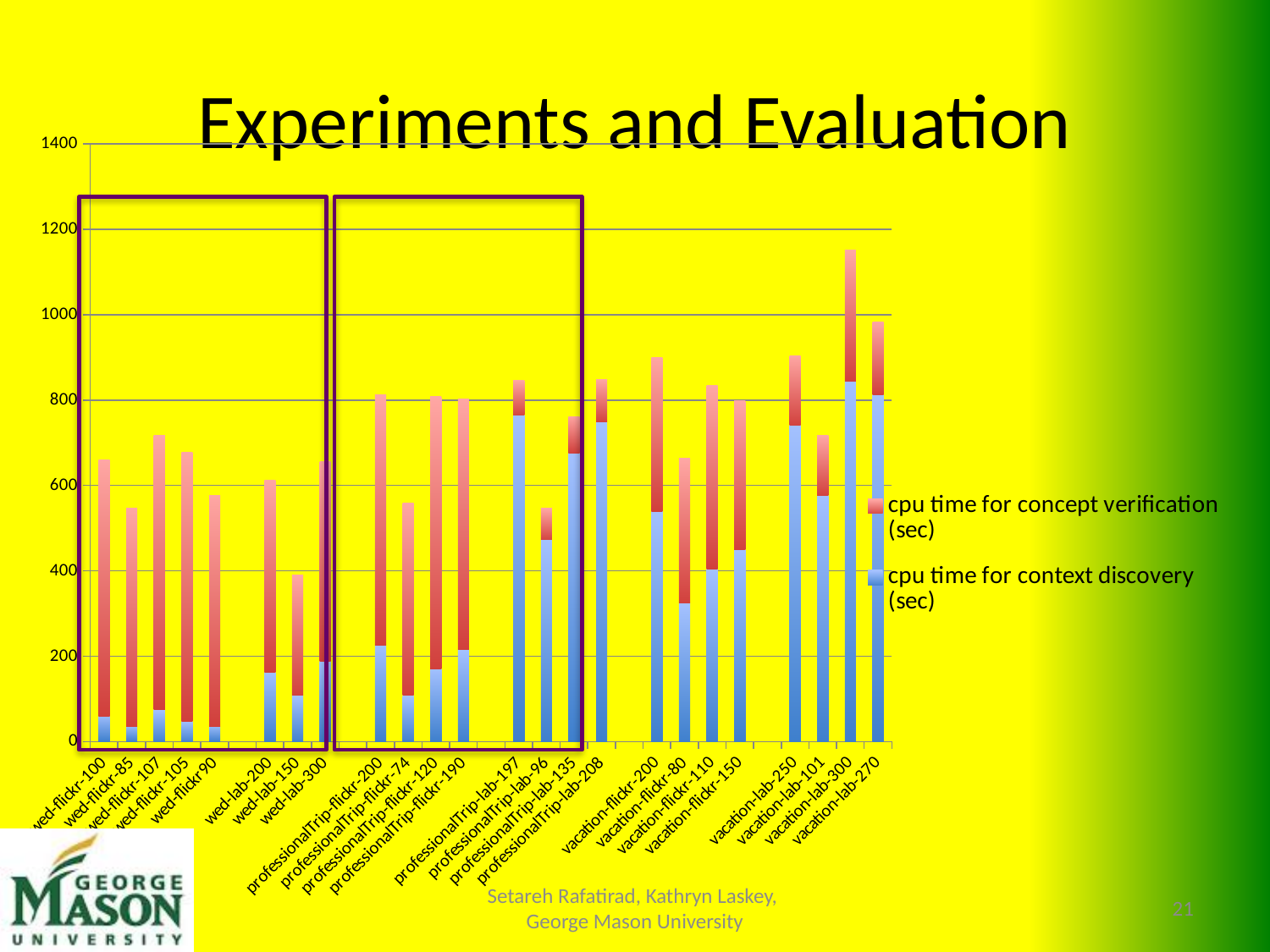
Which category has the shortest stacked bar? wed-lab-150 Which has the taller stacked bar, vacation-lab-300 or vacation-lab-270? vacation-lab-300 How many categories are plotted along the x axis? 24 Which has the taller stacked bar, wed-flickr-107 or wed-flickr-85? wed-flickr-107 Which category has the tallest stacked bar? vacation-lab-300 Is the cpu time for context discovery (sec) for professionalTrip-lab-197 greater or less than 600? greater Is the total stacked value for vacation-lab-300 greater or less than 1000? greater Is the total stacked value for wed-lab-150 greater or less than 600? less How many series does the legend list? 2 What kind of chart is shown on the slide? bar chart Which series is shown in blue in the legend? cpu time for context discovery (sec)